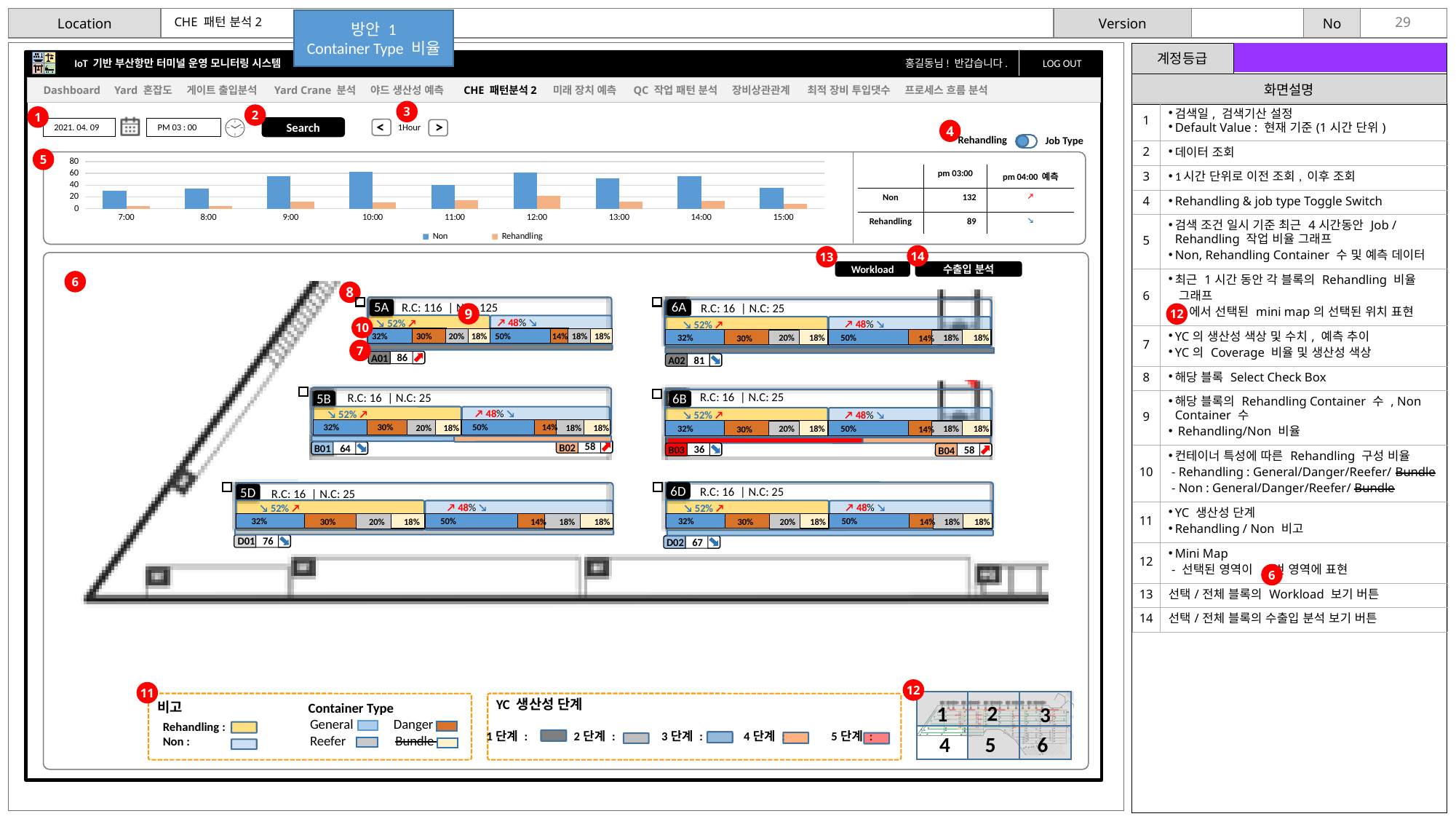
In the top bar chart, is the Non value at 7:00 greater or less than 40? less In the top bar chart, which Non bar is taller, 10:00 or 7:00? 10:00 In the top bar chart, which is larger at 12:00, the Non bar or the Rehandling bar? Non In the top bar chart, is the Non value at 11:00 greater or less than 60? less In the top bar chart, is the Non value at 10:00 greater or less than 40? greater In the top bar chart, at which time is the Rehandling bar highest? 12:00 In the top bar chart, which colour represents the Rehandling series? orange What are the two series named in the legend of the top bar chart? Non and Rehandling What kind of chart is shown at the top of the dashboard (item 5)? bar chart How many series does the legend of the top bar chart list? 2 How many time categories are shown on the x axis of the top bar chart? 9